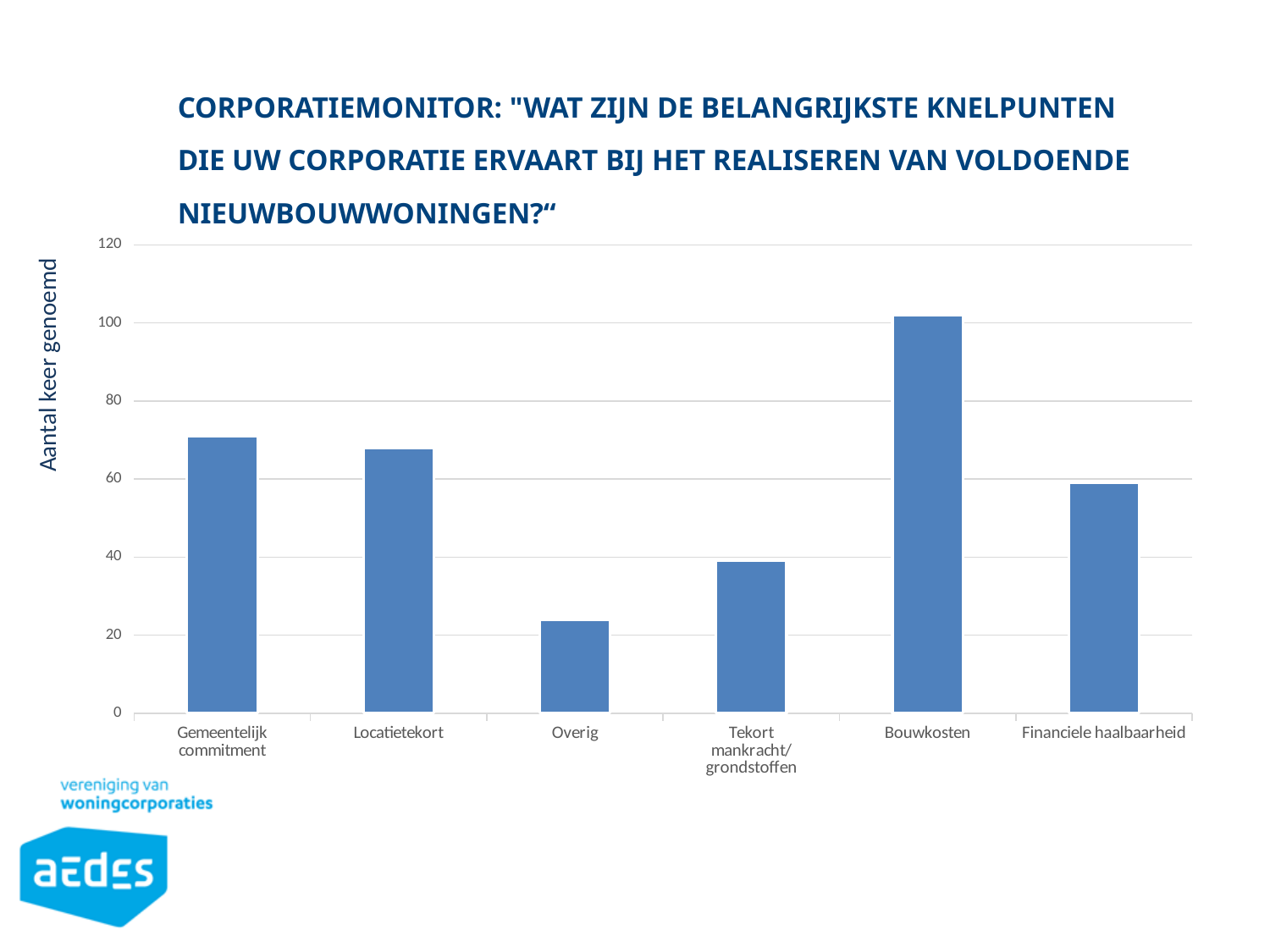
Which category has the highest value in the chart? Bouwkosten What is the label of the vertical axis of the chart? Aantal keer genoemd How many categories are shown on the x axis of the chart? 6 Is the value for Tekort mankracht/grondstoffen greater or less than 60? less Is the value for Overig greater or less than 40? less What kind of chart is shown on the slide? bar chart Which category has the lowest value in the chart? Overig Which is larger, the value for Gemeentelijk commitment or the value for Financiele haalbaarheid? Gemeentelijk commitment Which is larger, the value for Bouwkosten or the value for Financiele haalbaarheid? Bouwkosten Is the value for Bouwkosten greater or less than 80? greater Which is larger, the value for Locatietekort or the value for Tekort mankracht/grondstoffen? Locatietekort